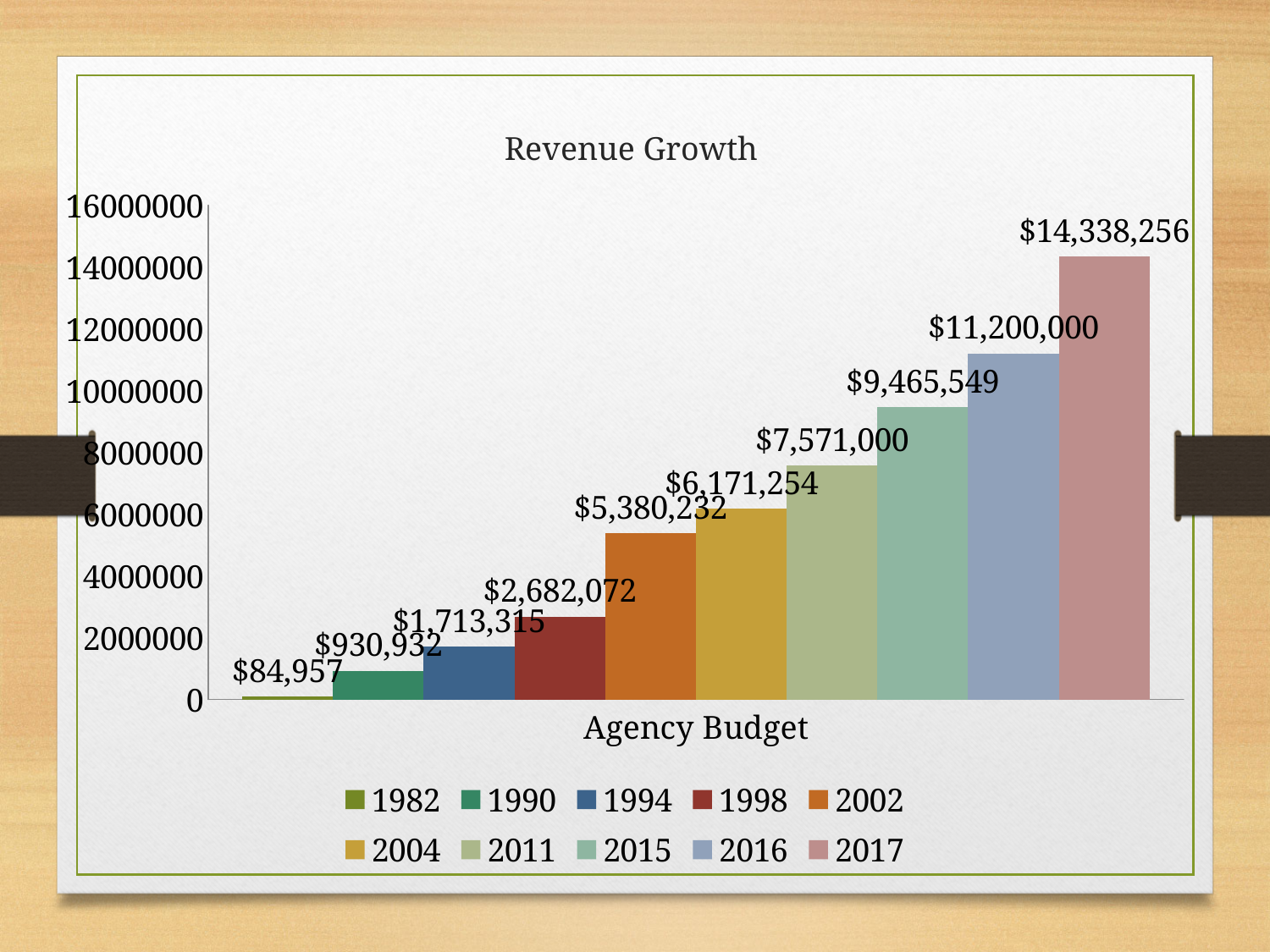
What is the value for 1982 in the Revenue Growth chart? $84,957 What kind of chart is shown on the slide? Bar chart Do the values in the Revenue Growth chart rise or fall from 1982 to 2017? Rise What is the difference between the 2004 and 2002 values in the Revenue Growth chart? $791,022 What is the value for 2011 in the Revenue Growth chart? $7,571,000 What is the value for 2002 in the Revenue Growth chart? $5,380,232 Which is larger in the Revenue Growth chart, the value for 1998 or the value for 1994? 1998 Which year has the lowest value in the Revenue Growth chart? 1982 What is the difference between the 2017 and 2016 values in the Revenue Growth chart? $3,138,256 Which year has the highest value in the Revenue Growth chart? 2017 How many series does the legend of the Revenue Growth chart list? 10 What is the value for 2017 in the Revenue Growth chart? $14,338,256